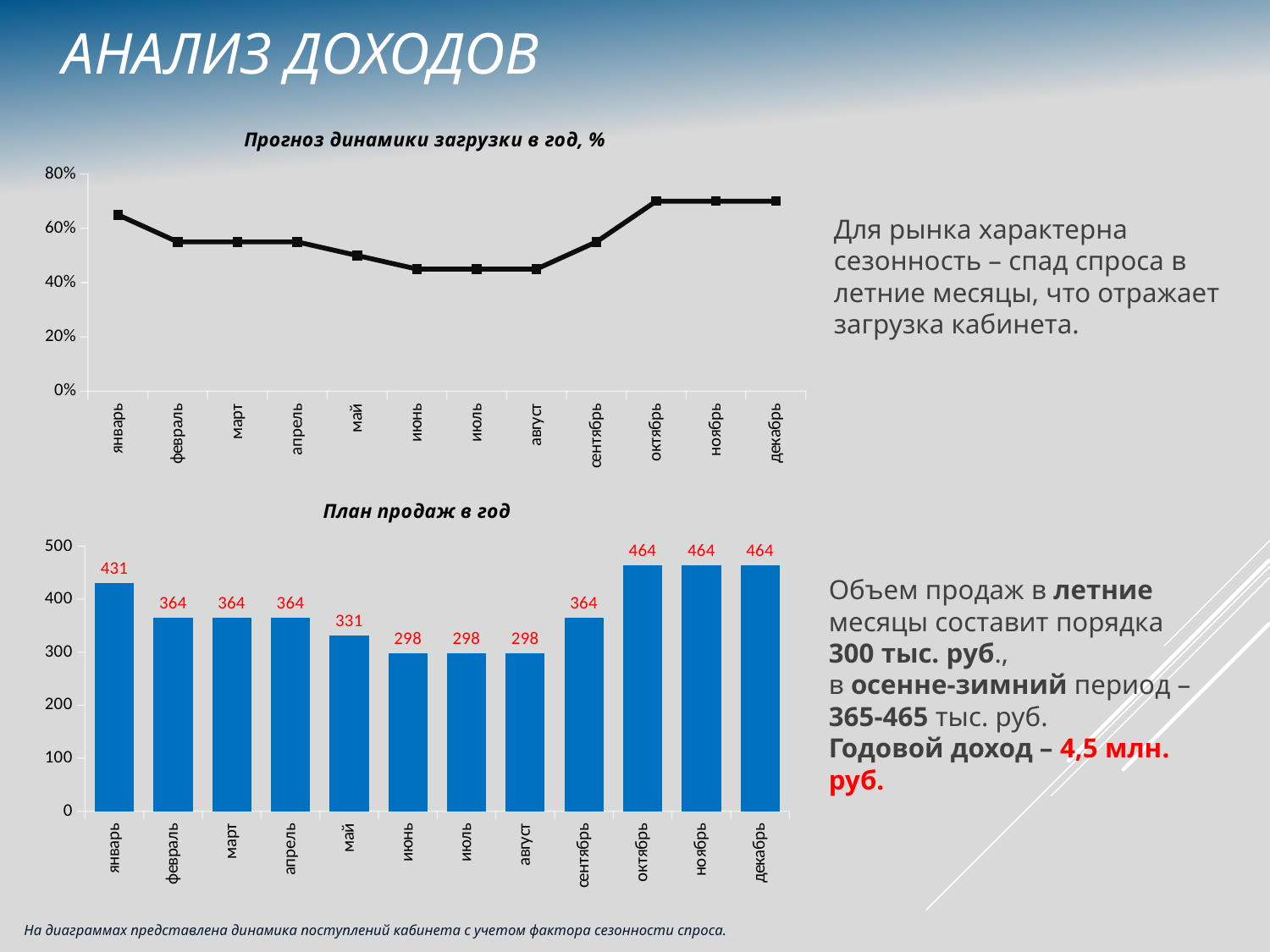
On the chart titled "План продаж в год", what is the difference between the values for октябрь and январь? 33 On the chart titled "План продаж в год", how many months are shown on the x axis? 12 On the chart titled "План продаж в год", what is the difference between the values for февраль and июнь? 66 What kind of chart is the chart titled "План продаж в год"? bar chart On the chart titled "План продаж в год", which month has the lowest value? июнь, июль and август (298) On the chart titled "Прогноз динамики загрузки в год, %", which is larger, the value for ноябрь or the value for июнь? ноябрь What kind of chart is the chart titled "Прогноз динамики загрузки в год, %"? line chart On the chart titled "Прогноз динамики загрузки в год, %", is the value for июль greater or less than 60%? less On the chart titled "План продаж в год", what is the value for июль? 298 On the chart titled "План продаж в год", what is the value for январь? 431 On the chart titled "План продаж в год", which is larger, the value for сентябрь or the value for май? сентябрь On the chart titled "План продаж в год", what is the value for май? 331